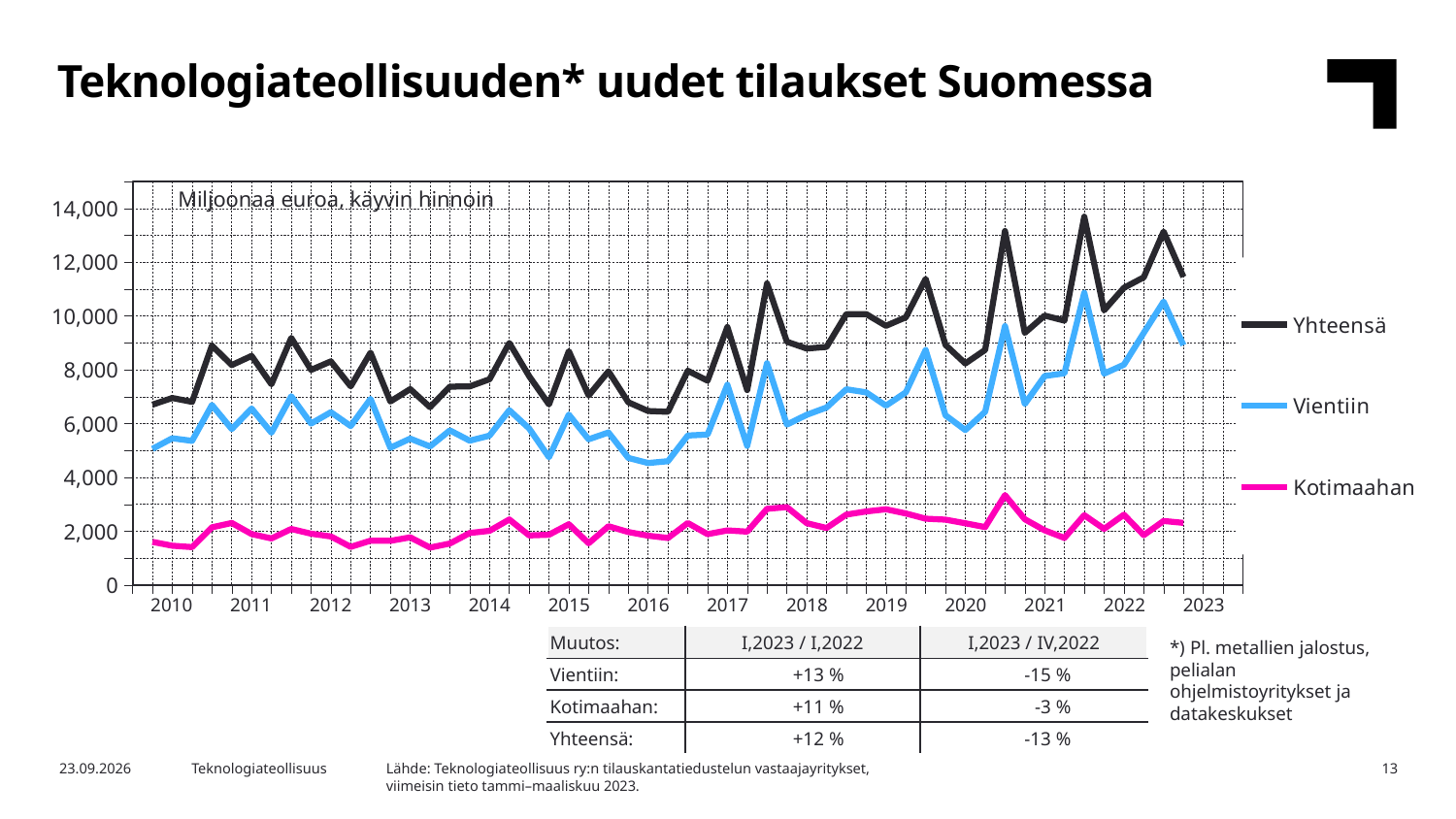
What unit is stated in the label at the top of the chart? Miljoonaa euroa, käyvin hinnoin How many year labels are shown on the x axis? 14 Which series are listed in the legend? Yhteensä, Vientiin, Kotimaahan Which is larger in 2020: the value for Yhteensä or the value for Kotimaahan? Yhteensä How many series does the legend list? 3 Does the Yhteensä series overall rise or fall from 2010 to 2023? rise What kind of chart is shown on the slide? line chart Which series reaches the highest value on the chart? Yhteensä Is the peak value for Yhteensä in 2021 greater or less than 12,000? greater Is the lowest value for Vientiin in 2016 greater or less than 6,000? less Which series has the lowest values throughout the chart? Kotimaahan Is the value for Kotimaahan at the start of 2010 greater or less than 4,000? less